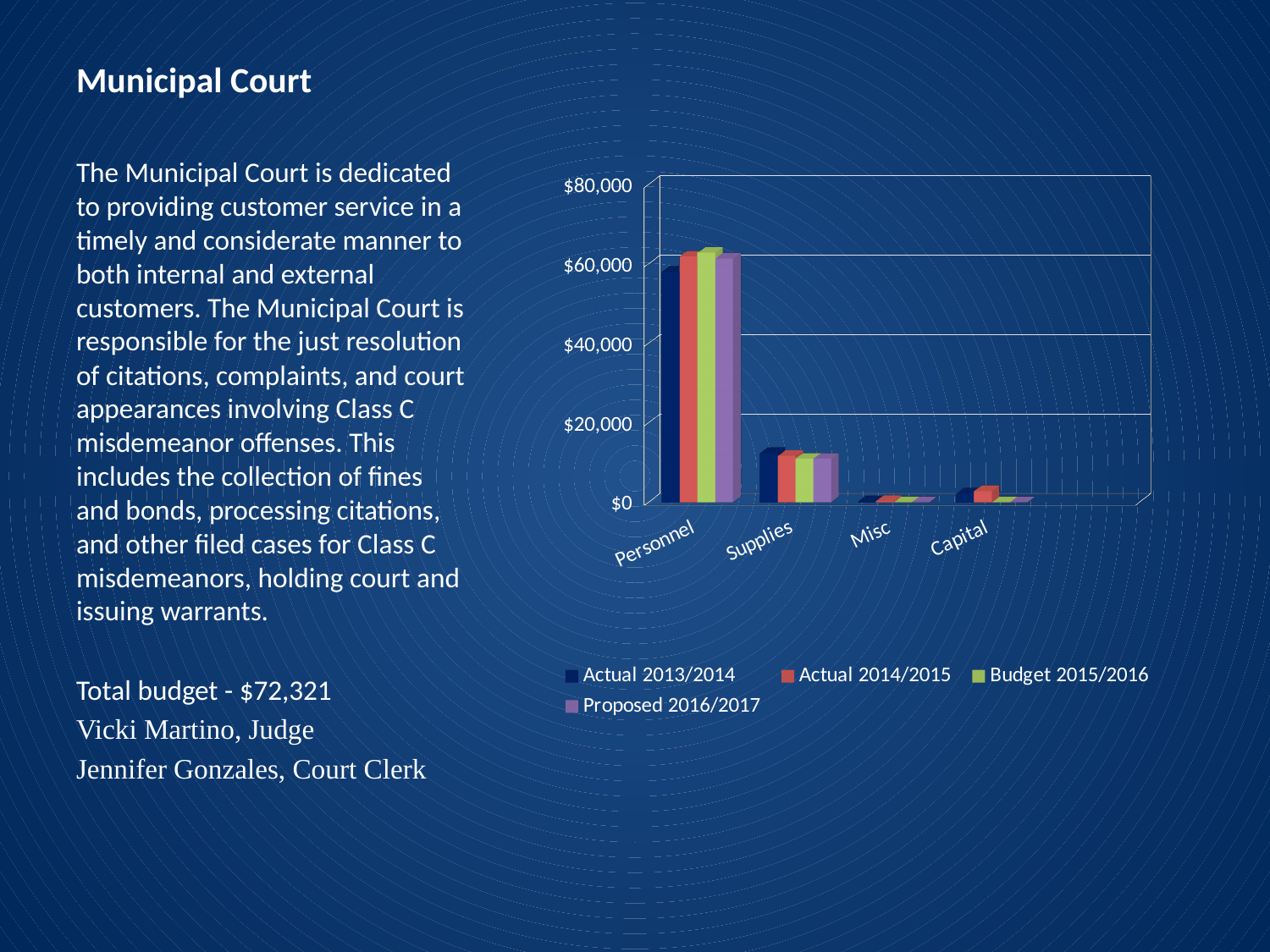
Is the Proposed 2016/2017 value for Capital greater or less than $20,000? less How many series does the chart's legend list? 4 Which category has the lowest values in the chart? Misc Which category has the highest values in the chart? Personnel What kind of chart is shown on the slide? bar chart Which is larger, the Actual 2013/2014 value for Personnel or the Actual 2013/2014 value for Supplies? Personnel What is the highest value shown on the chart's vertical axis? $80,000 How many categories are shown on the x axis of the chart? 4 Which is larger, the Actual 2014/2015 value for Capital or the Actual 2014/2015 value for Misc? Capital What is the first series listed in the chart's legend? Actual 2013/2014 Is the Budget 2015/2016 value for Supplies greater or less than $20,000? less Is the Actual 2014/2015 value for Personnel greater or less than $40,000? greater